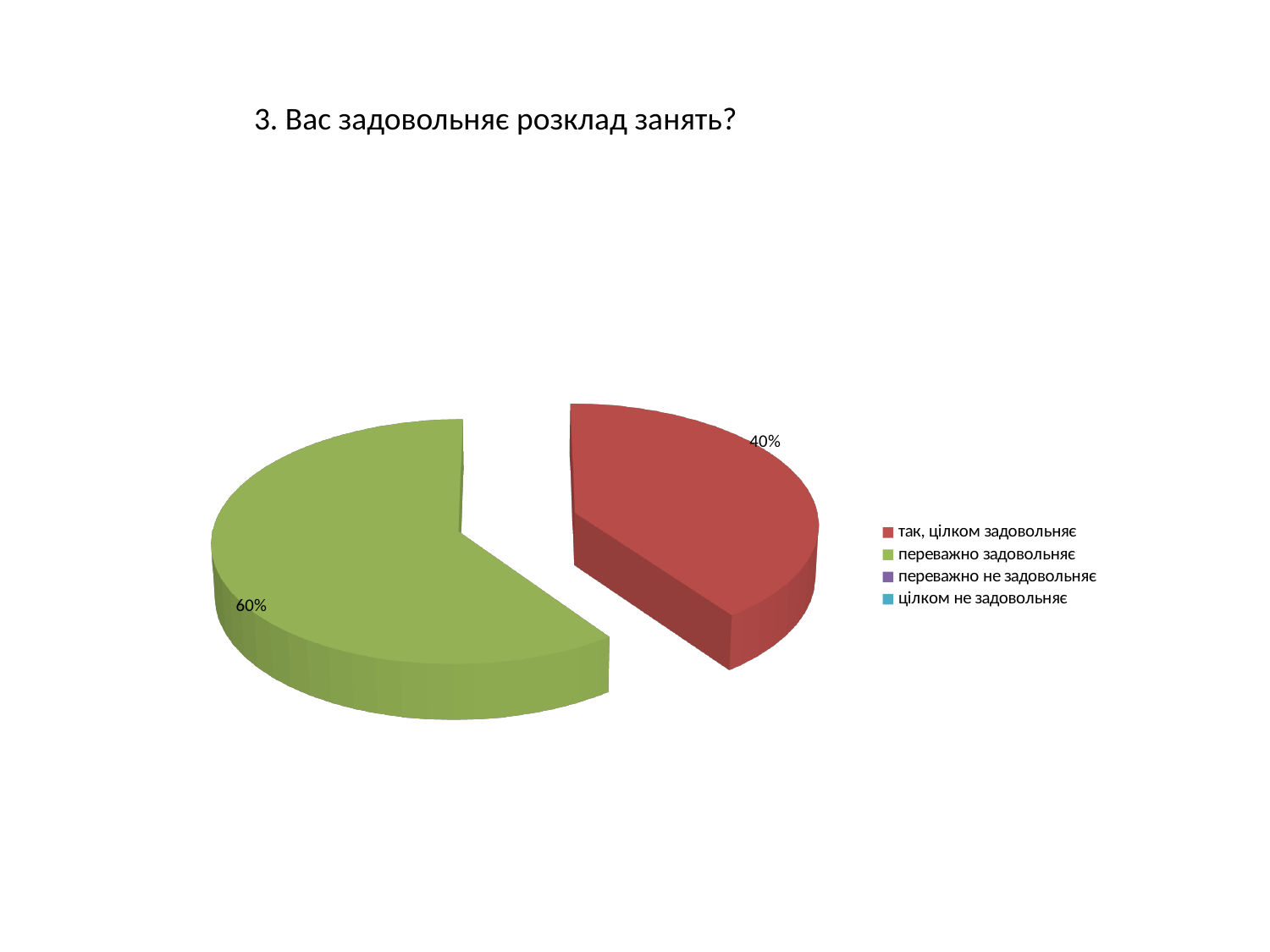
What kind of chart is shown on the slide? pie chart What is the title of the chart? 3. Вас задовольняє розклад занять? What is the difference in percentage points between the "переважно задовольняє" slice and the "так, цілком задовольняє" slice? 20% What colour is the slice for "переважно задовольняє"? green What share of the pie does "переважно задовольняє" have? 60% How many entries does the legend list? 4 Which is larger: the share for "так, цілком задовольняє" or the share for "переважно задовольняє"? переважно задовольняє Which of the two visible slices is smaller, "так, цілком задовольняє" or "переважно задовольняє"? так, цілком задовольняє How many slices are visible in the pie? 2 What share of the pie does "так, цілком задовольняє" have? 40% Which category has the largest slice of the pie? переважно задовольняє